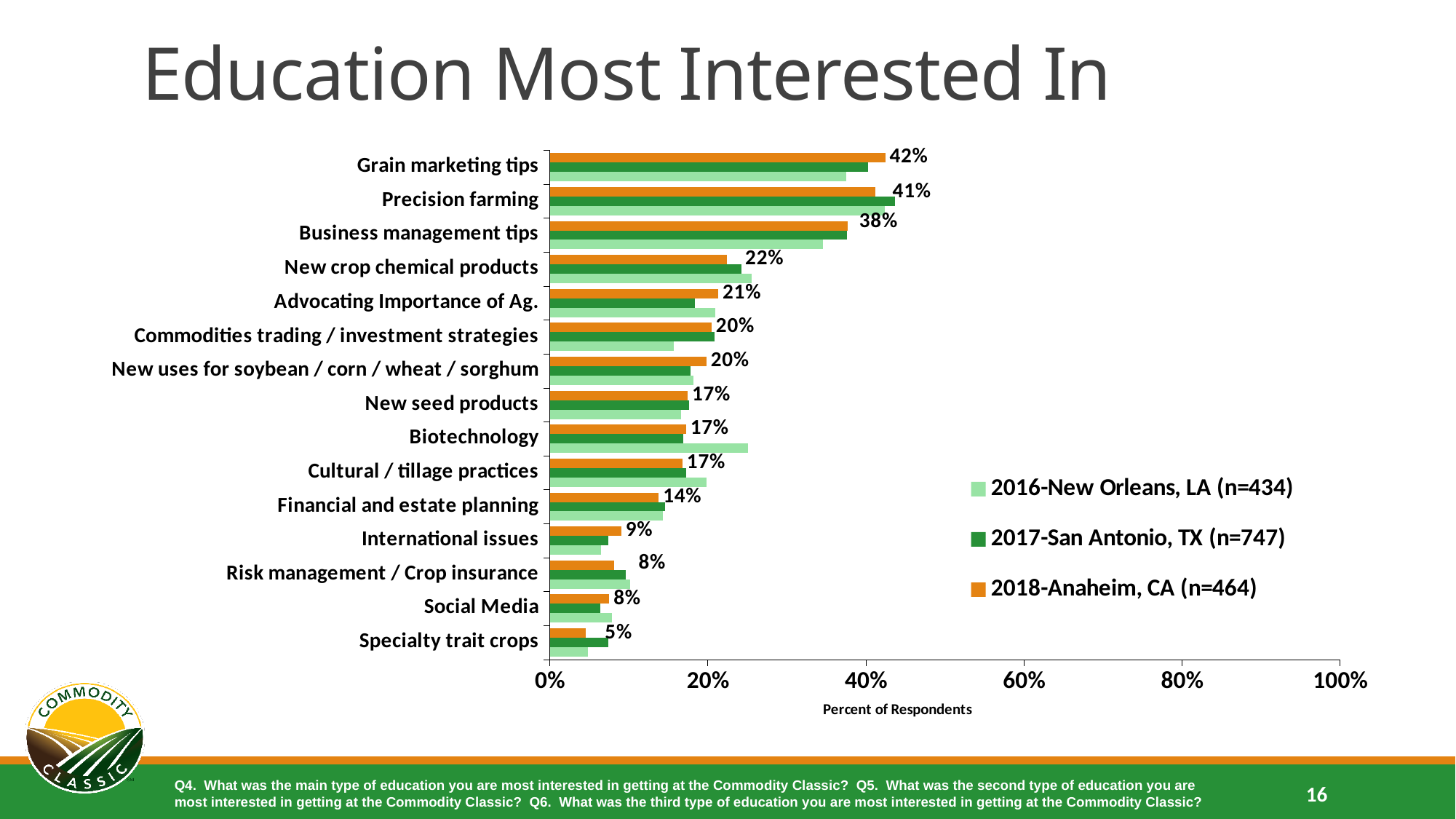
What is the 2018-Anaheim, CA value for Financial and estate planning? 14% What is the 2018-Anaheim, CA value for Grain marketing tips? 42% For 2018-Anaheim, CA, which is larger: New crop chemical products or International issues? New crop chemical products What is the difference between the 2018-Anaheim, CA values for Grain marketing tips and Specialty trait crops? 37 percentage points How many series does the legend list? 3 How many education categories are plotted on the chart? 15 Which category has the highest 2018-Anaheim, CA value? Grain marketing tips What is the 2018-Anaheim, CA value for Business management tips? 38% Is the 2017-San Antonio, TX value for Precision farming greater or less than 40%? greater What kind of chart is shown on the slide? Bar chart Which category has the lowest 2018-Anaheim, CA value? Specialty trait crops What is the title of the horizontal axis? Percent of Respondents